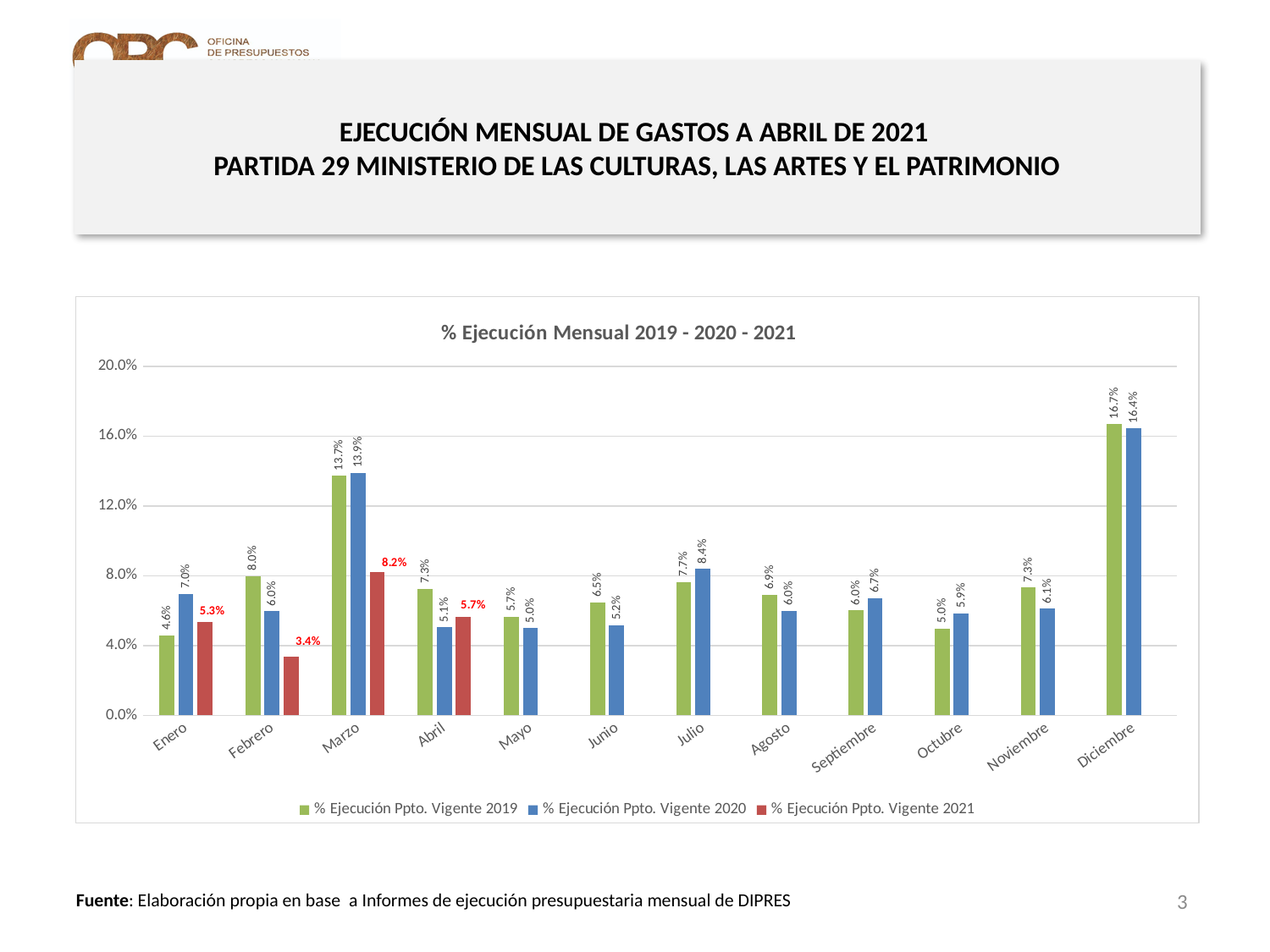
What kind of chart is shown on the slide? Bar chart Which is larger in Abril: the 2019 value or the 2020 value? 2019 value What is the value for % Ejecución Ppto. Vigente 2020 in Julio? 8.4% How many series does the legend list? 3 How many months are shown on the x axis? 12 What is the value for % Ejecución Ppto. Vigente 2019 in Diciembre? 16.7% What is the difference between the 2019 and 2020 values in Enero? 2.4% What is the value for % Ejecución Ppto. Vigente 2021 in Marzo? 8.2% What is the title of the chart? % Ejecución Mensual 2019 - 2020 - 2021 Which month has the highest value for % Ejecución Ppto. Vigente 2020? Diciembre Is the value for % Ejecución Ppto. Vigente 2019 in Marzo greater or less than 12.0%? greater Which month has the lowest value for % Ejecución Ppto. Vigente 2021? Febrero